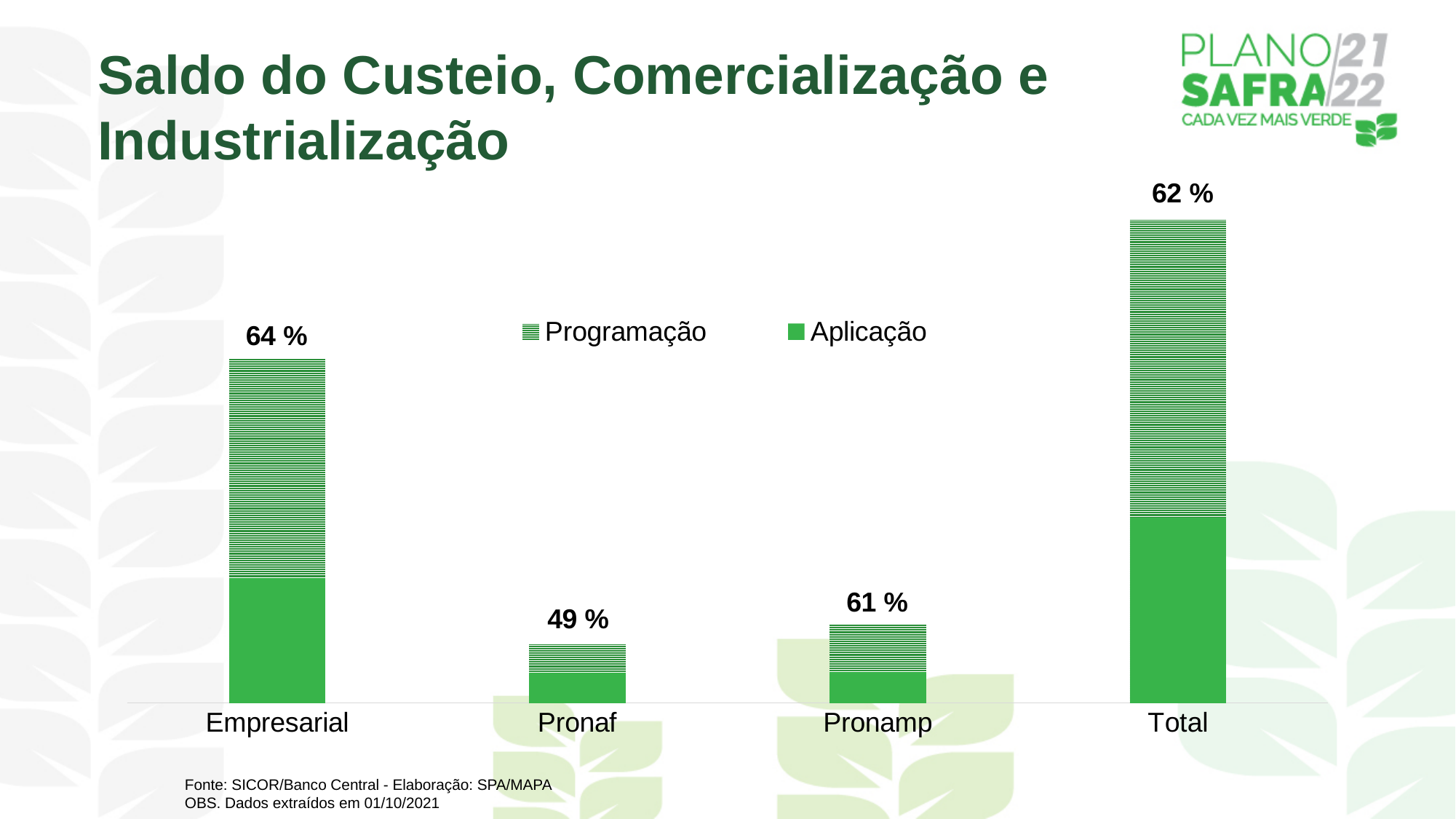
How many categories are shown on the x axis? 4 What are the two series named in the legend? Programação and Aplicação Which category has the highest percentage label? Empresarial What is the difference between the percentage labels for Empresarial and Pronaf? 15 % What percentage label is shown above the Pronamp bar? 61 % How many series does the legend list? 2 What percentage label is shown above the Total bar? 62 % What percentage label is shown above the Pronaf bar? 49 % Which has a higher percentage label, Pronamp or Total? Total What percentage label is shown above the Empresarial bar? 64 % Which category has the lowest percentage label? Pronaf What kind of chart is shown on the slide? Bar chart